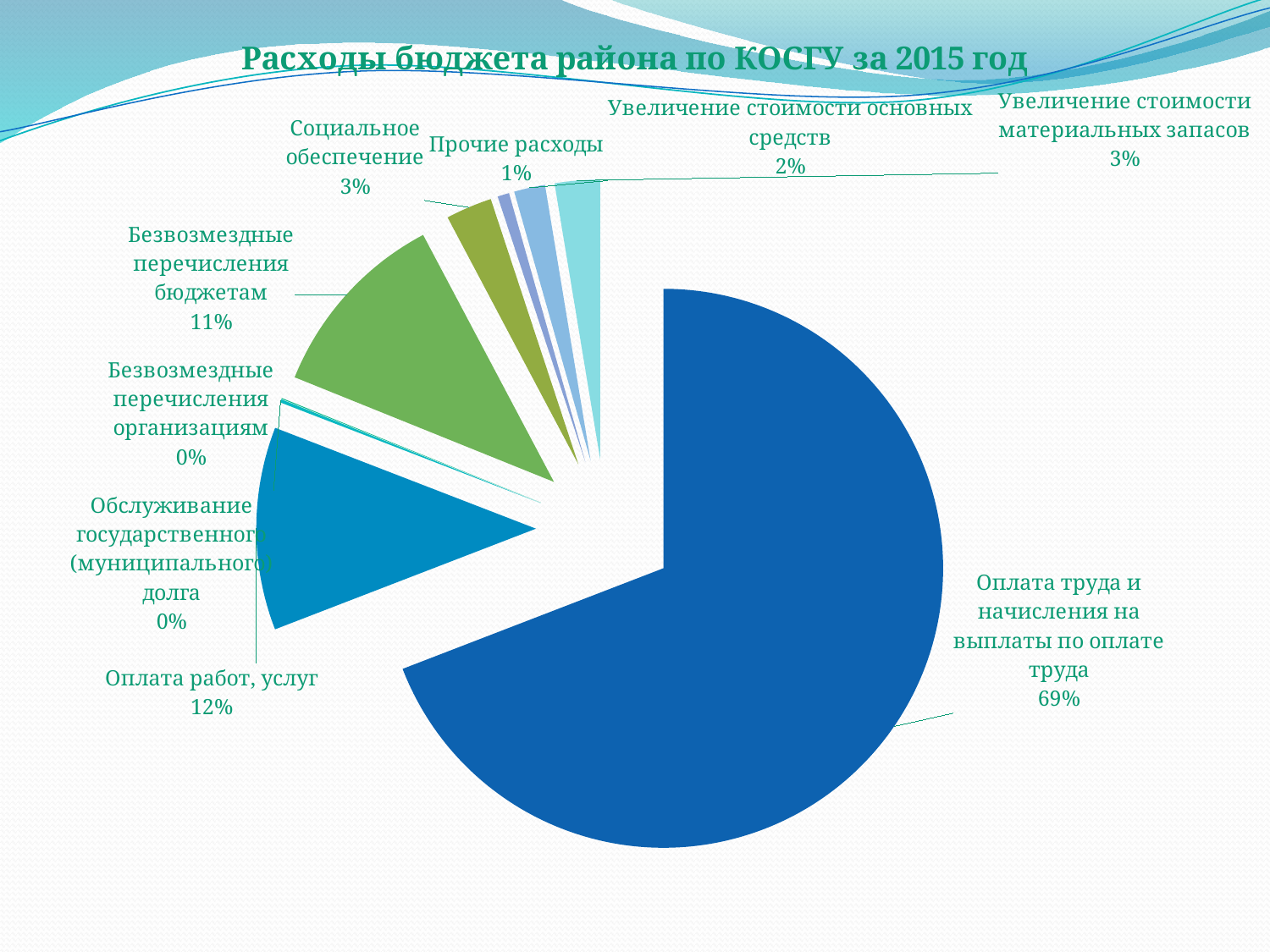
What share of the pie is "Оплата труда и начисления на выплаты по оплате труда"? 69% What is the difference between the shares of "Оплата труда и начисления на выплаты по оплате труда" and "Оплата работ, услуг"? 57% Which is larger: "Социальное обеспечение" or "Прочие расходы"? Социальное обеспечение What is the value for "Безвозмездные перечисления бюджетам"? 11% Which category has the largest share of the pie? Оплата труда и начисления на выплаты по оплате труда What is the title of the chart? Расходы бюджета района по КОСГУ за 2015 год What is the value for "Увеличение стоимости основных средств"? 2% What is the value for "Оплата работ, услуг"? 12% How many categories are shown in the pie chart? 9 What type of chart is shown on the slide? pie chart What is the value for "Прочие расходы"? 1% What is the difference between the shares of "Оплата работ, услуг" and "Безвозмездные перечисления бюджетам"? 1%